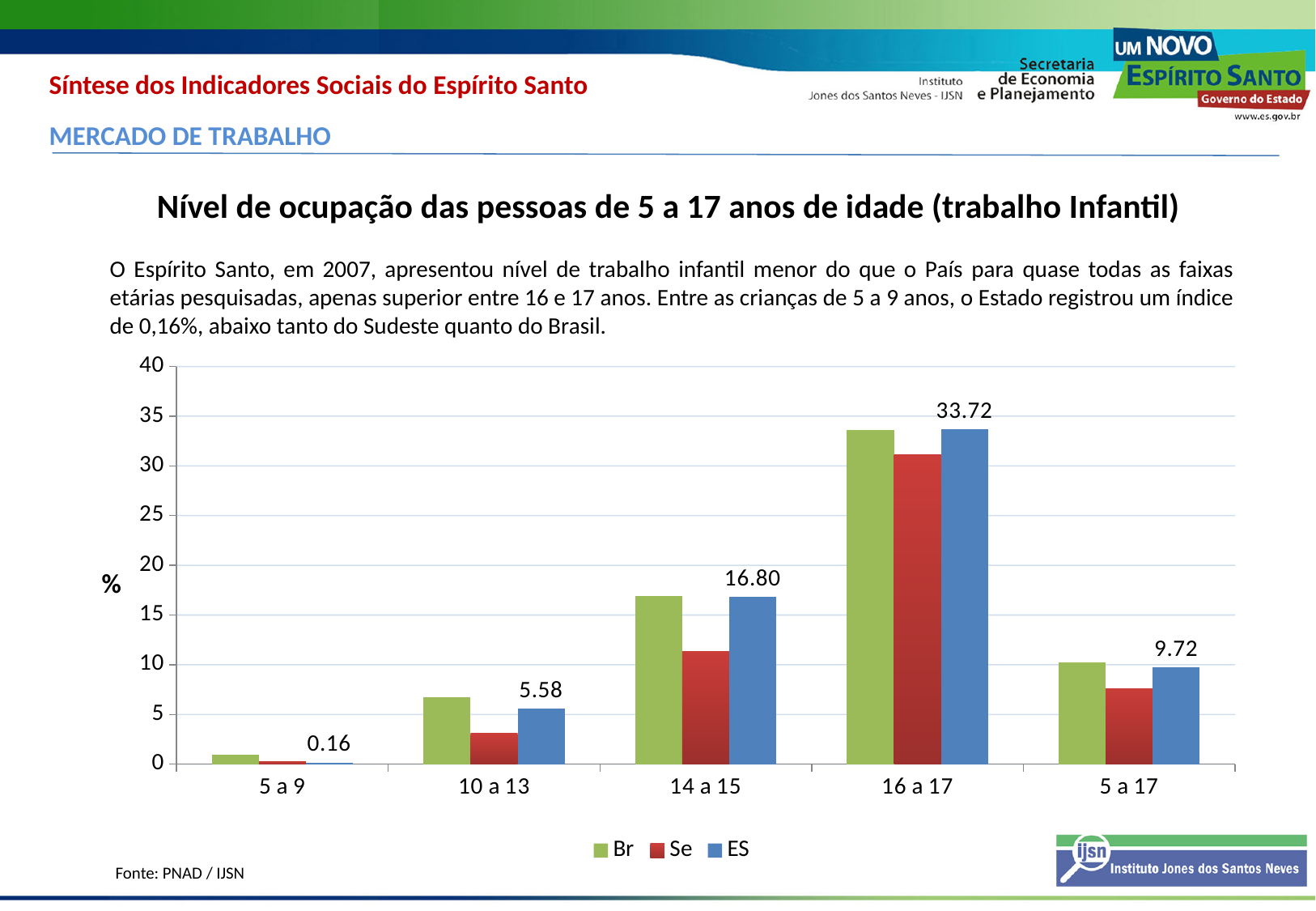
What is the value for ES in the 5 a 9 age group? 0.16 What is the value for ES in the 14 a 15 age group? 16.80 What is the value for ES in the 5 a 17 age group? 9.72 What is the value for ES in the 16 a 17 age group? 33.72 For the ES series, which age group has the lowest value? 5 a 9 How many series does the legend list? 3 For the ES series, which age group has the highest value? 16 a 17 How many age groups are shown on the x axis? 5 What kind of chart is shown on the slide? bar chart In the 14 a 15 age group, which is larger, Br or Se? Br What is the difference between the ES values for 16 a 17 and 14 a 15? 16.92 Is the value for Se in the 14 a 15 age group greater or less than 15? less